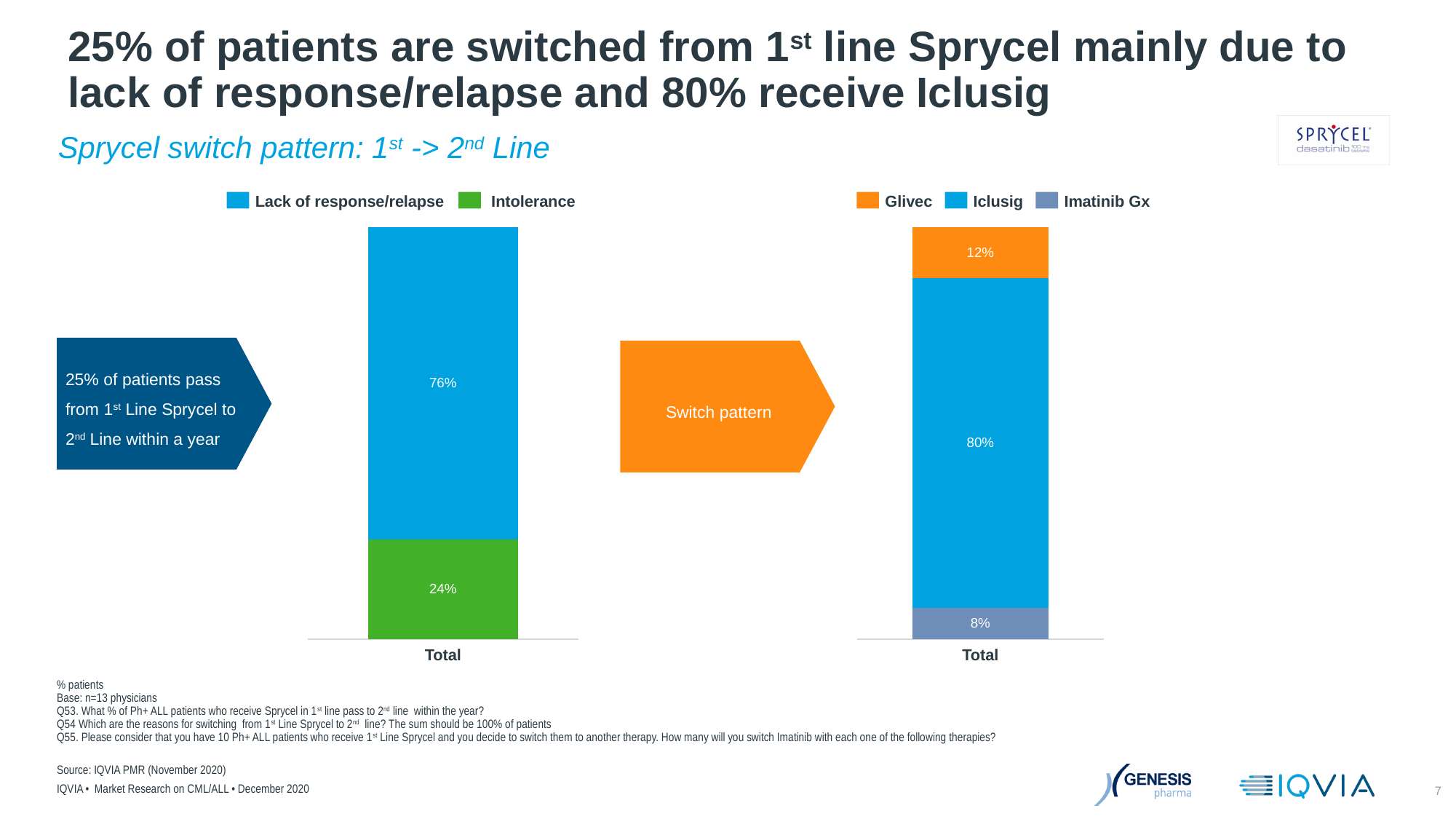
How many series does the legend of the right chart (switch pattern) list? 3 In the right chart (switch pattern), what is the value for Glivec? 12% In the right chart (switch pattern), which therapy has the lowest share? Imatinib Gx In the right chart (switch pattern), what is the value for Imatinib Gx? 8% In the right chart (switch pattern), which therapy has the highest share? Iclusig In the left chart (reasons for switching), what is the value for Intolerance? 24% In the right chart (switch pattern), what is the total of the stacked bar? 100% In the left chart (reasons for switching), what is the value for Lack of response/relapse? 76% In the right chart (switch pattern), which is larger, Glivec or Imatinib Gx? Glivec In the right chart (switch pattern), what is the value for Iclusig? 80% In the left chart (reasons for switching), what is the difference between Lack of response/relapse and Intolerance? 52% What kind of chart is the left chart (reasons for switching)? Stacked bar chart